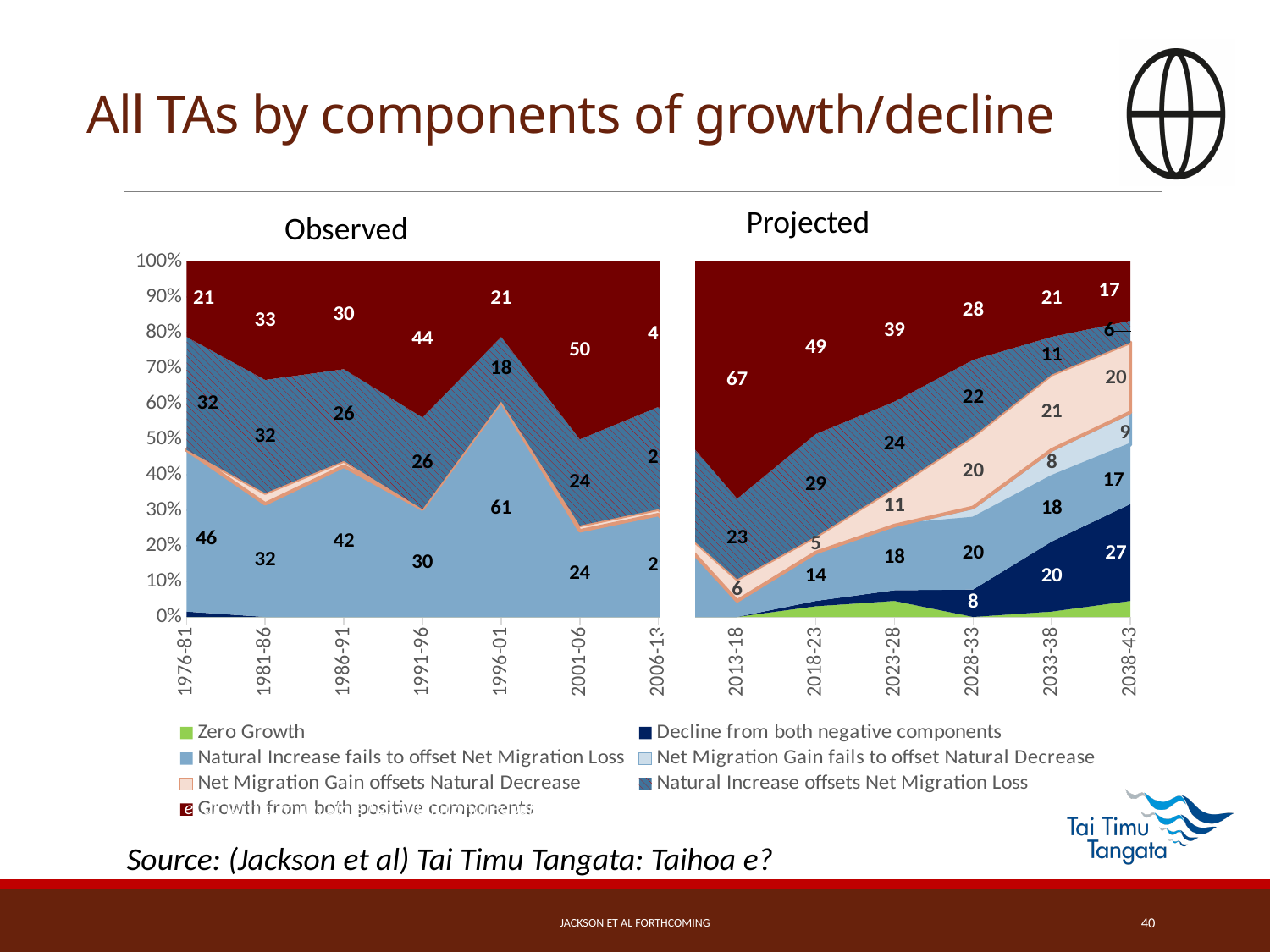
In the Observed chart, what is the value for Growth from both positive components in 2001-06? 50 How many series does the legend list? 7 In the Observed chart, which is larger for Growth from both positive components: 1981-86 or 1986-91? 1981-86 In the Projected chart, what is the value for Growth from both positive components in 2013-18? 67 In the Projected chart, what is the value for Decline from both negative components in 2038-43? 27 In the Projected chart, what is the difference between the Growth from both positive components values for 2013-18 and 2038-43? 50 In the Projected chart, which period has the lowest value for Growth from both positive components? 2038-43 In the Observed chart, which period has the highest value for Natural Increase fails to offset Net Migration Loss? 1996-01 How many periods are shown on the x axis of the Projected chart? 6 How many periods are shown on the x axis of the Observed chart? 7 In the Projected chart, does the value for Growth from both positive components rise or fall from 2013-18 to 2038-43? fall What kind of chart is the Observed chart? stacked area chart